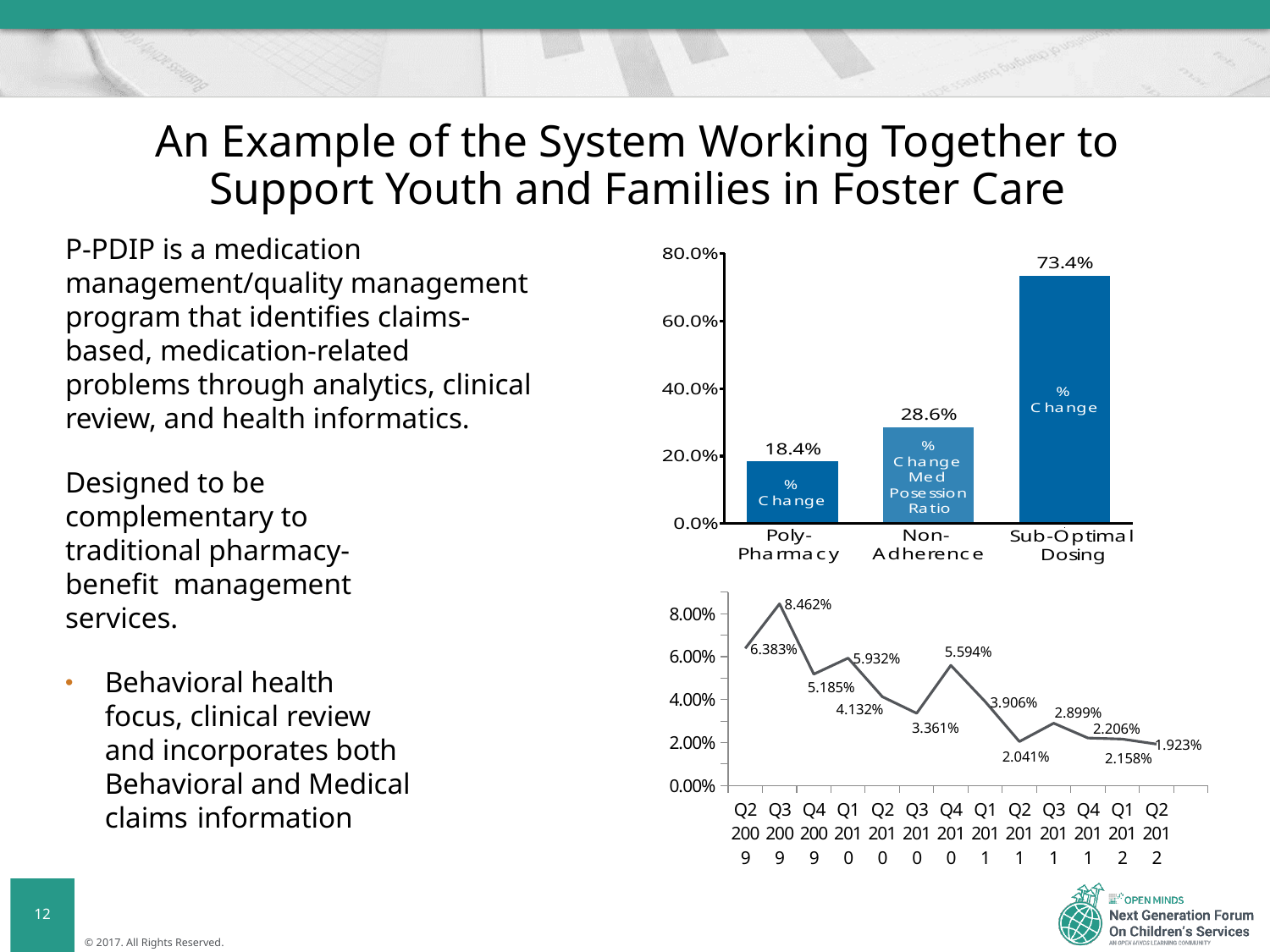
In the bottom line chart, what is the value for Q2 2012? 1.923% What kind of chart is the top chart on the slide? Bar chart In the bottom line chart, do the values generally rise or fall from Q2 2009 to Q2 2012? Fall In the bottom line chart, how many data points are plotted? 13 In the top bar chart, what is the value for Sub-Optimal Dosing? 73.4% In the top bar chart, how many categories are shown? 3 In the top bar chart, what is the value for Poly-Pharmacy? 18.4% In the top bar chart, which category has the highest value? Sub-Optimal Dosing In the bottom line chart, what is the value for Q3 2009? 8.462% In the top bar chart, which category has the lowest value? Poly-Pharmacy In the bottom line chart, which quarter has the highest value? Q3 2009 In the top bar chart, what is the difference between the Sub-Optimal Dosing value and the Non-Adherence value? 44.8%